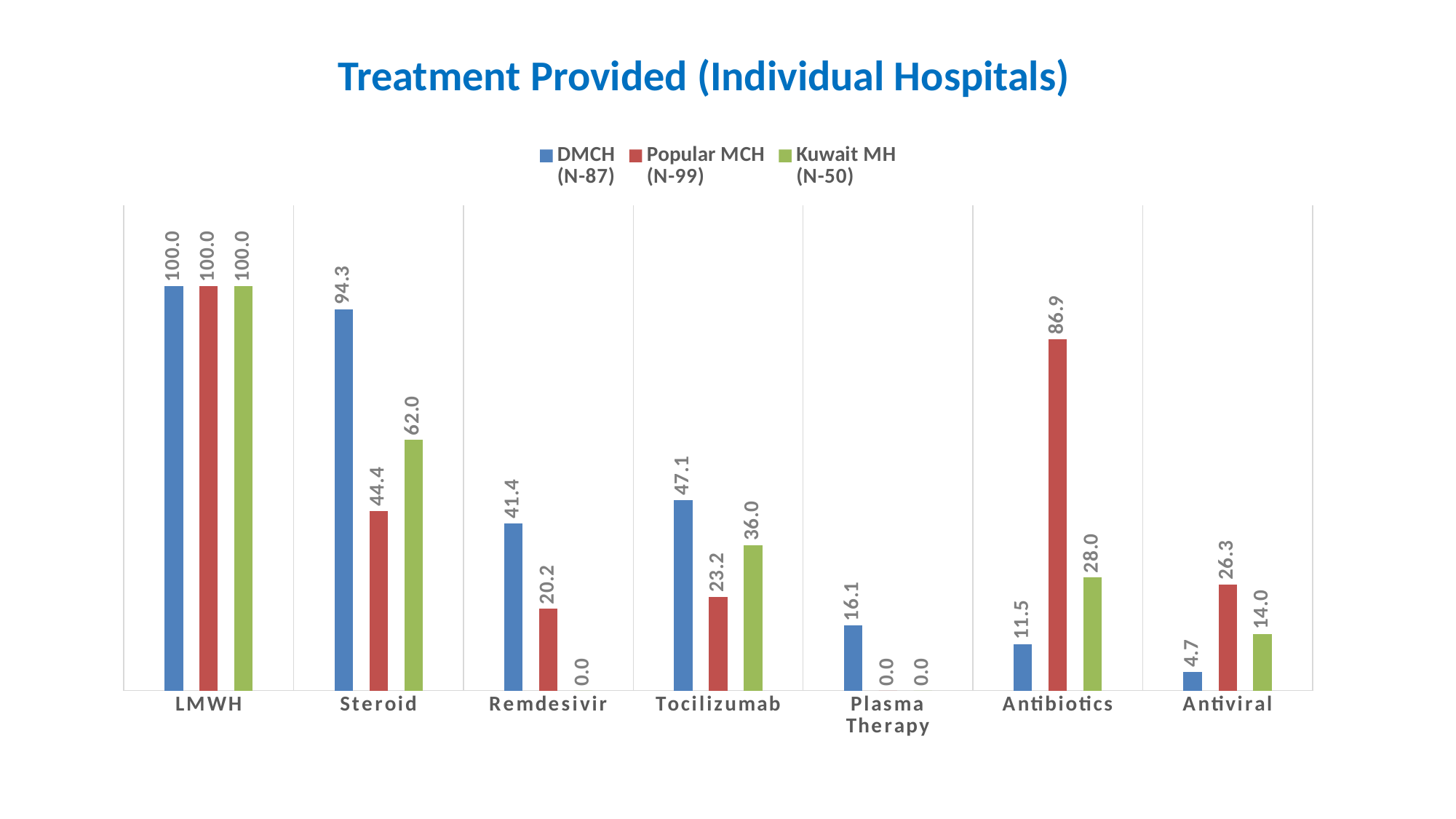
How many treatment categories are shown on the x axis? 7 What is the title of the chart? Treatment Provided (Individual Hospitals) What is the value for Kuwait MH (N-50) for Tocilizumab? 36.0 What is the value for Kuwait MH (N-50) for Remdesivir? 0.0 What kind of chart is shown on the slide? Bar chart Which treatment has the highest value for Kuwait MH (N-50), excluding LMWH? Steroid What is the difference between the DMCH (N-87) and Popular MCH (N-99) values for Steroid? 49.9 What is the value for Popular MCH (N-99) for Antibiotics? 86.9 What is the value for DMCH (N-87) for Steroid? 94.3 Which is larger for Antiviral: the Popular MCH (N-99) value or the Kuwait MH (N-50) value? Popular MCH (N-99) How many series does the legend list? 3 Which treatment has the lowest value for DMCH (N-87)? Antiviral